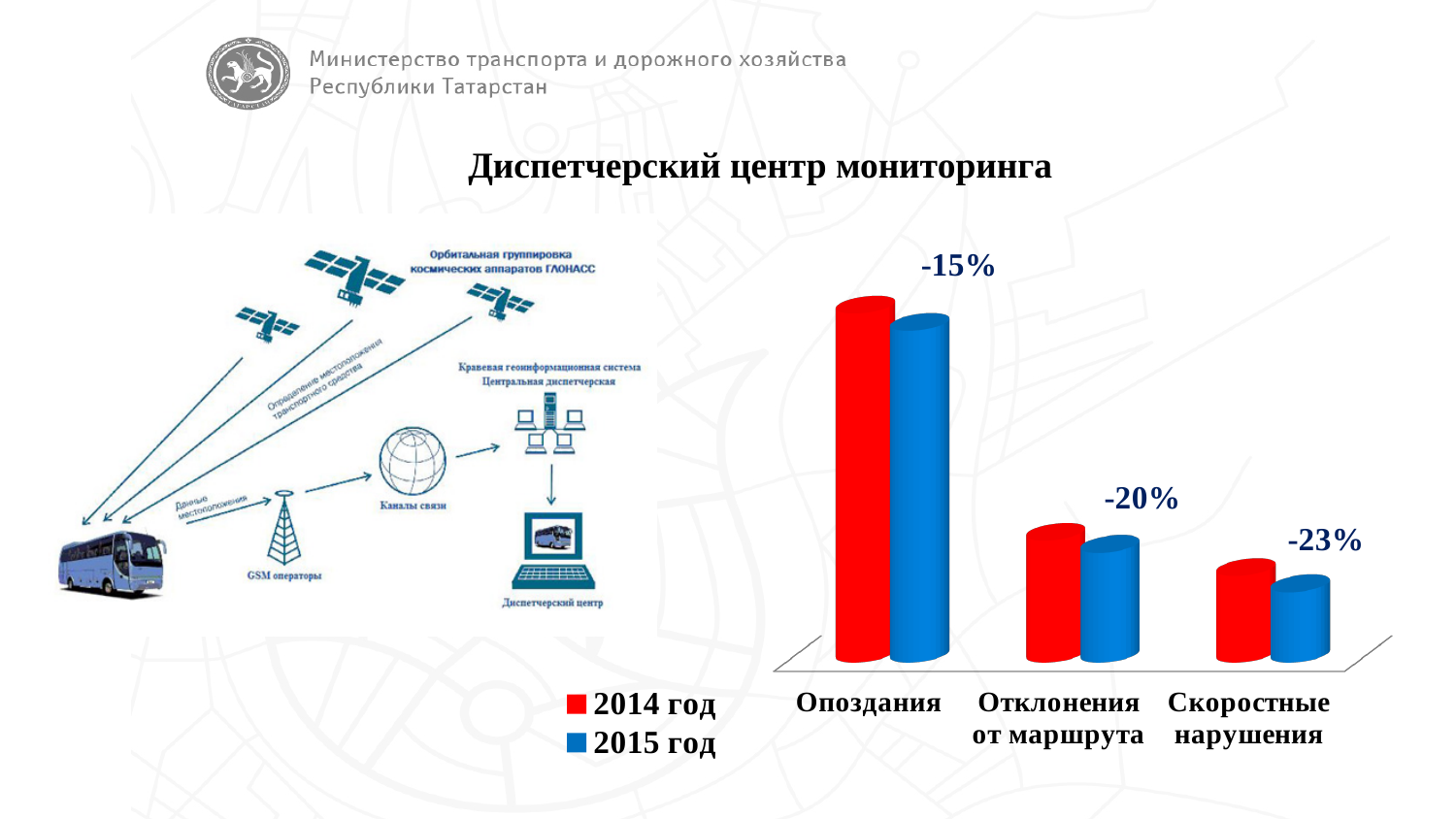
Which colour represents the 2015 год series in the chart? blue What percentage change is printed above the bars for Отклонения от маршрута? -20% Which category has the lowest bars in the chart? Скоростные нарушения For Скоростные нарушения, which series has the larger bar, 2014 год or 2015 год? 2014 год How many series does the legend of the bar chart list? 2 Do the bar heights rise or fall from left to right across the categories? fall What kind of chart is shown on the right side of the slide? bar chart What percentage change is printed above the bars for Скоростные нарушения? -23% What percentage change is printed above the bars for Опоздания? -15% For Опоздания, which series has the larger bar, 2014 год or 2015 год? 2014 год Which category has the highest bars in the chart? Опоздания How many categories are shown on the x axis of the bar chart? 3